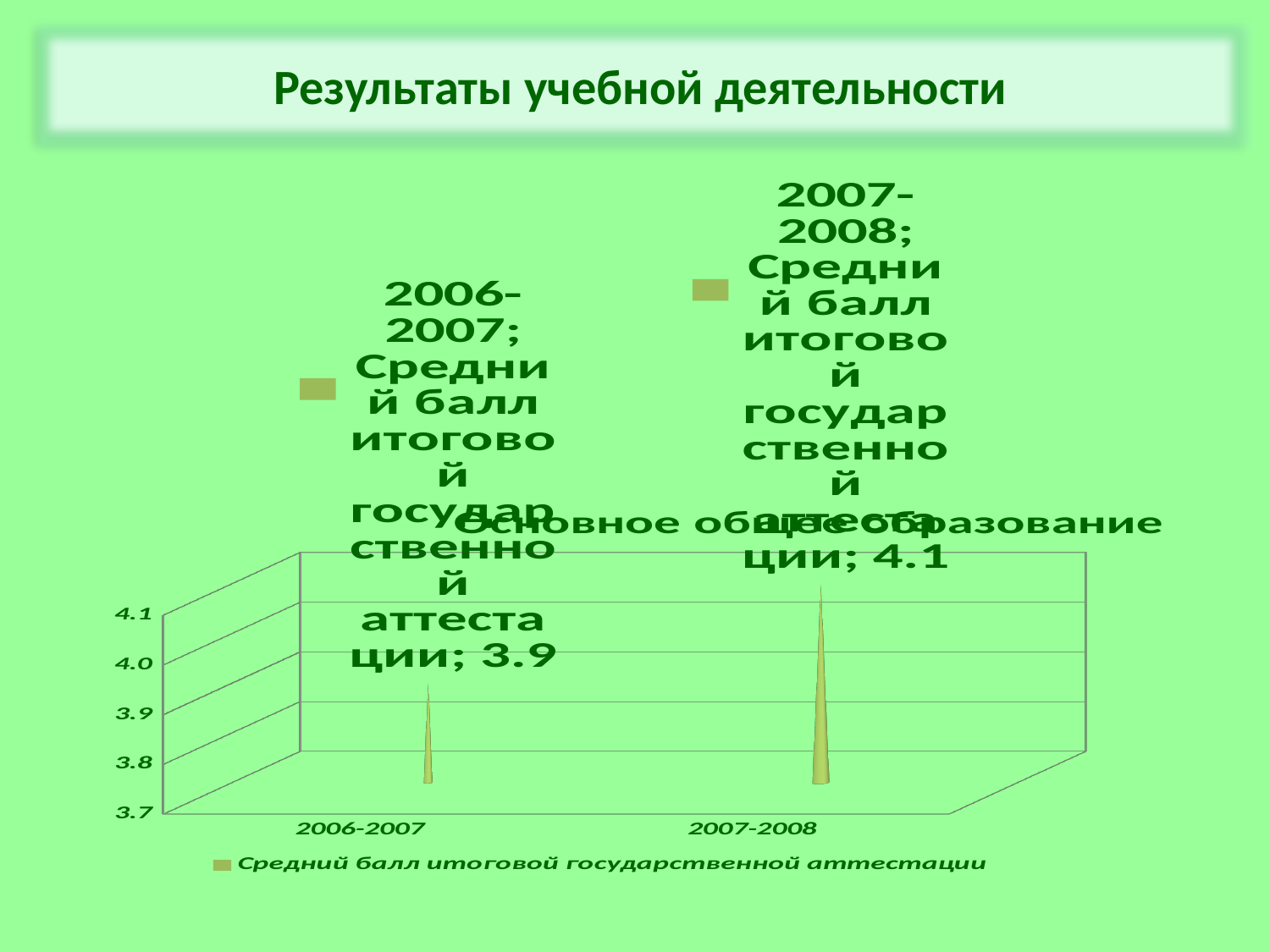
By how much did the average score increase from 2006-2007 to 2007-2008? 0.2 Is the value for 2006-2007 greater or less than 4.0? less What is the average final state certification score for 2007-2008? 4.1 Is the value for 2007-2008 greater or less than 4.0? greater Which academic year has the lower average final state certification score? 2006-2007 How many series does the chart legend list? 1 Do the values rise or fall from 2006-2007 to 2007-2008? rise What is the average final state certification score for 2006-2007? 3.9 How many academic years are shown on the x axis of the chart? 2 Which academic year has the higher average final state certification score? 2007-2008 Is the value for 2006-2007 larger or smaller than the value for 2007-2008? smaller What kind of chart is shown on the slide? bar chart